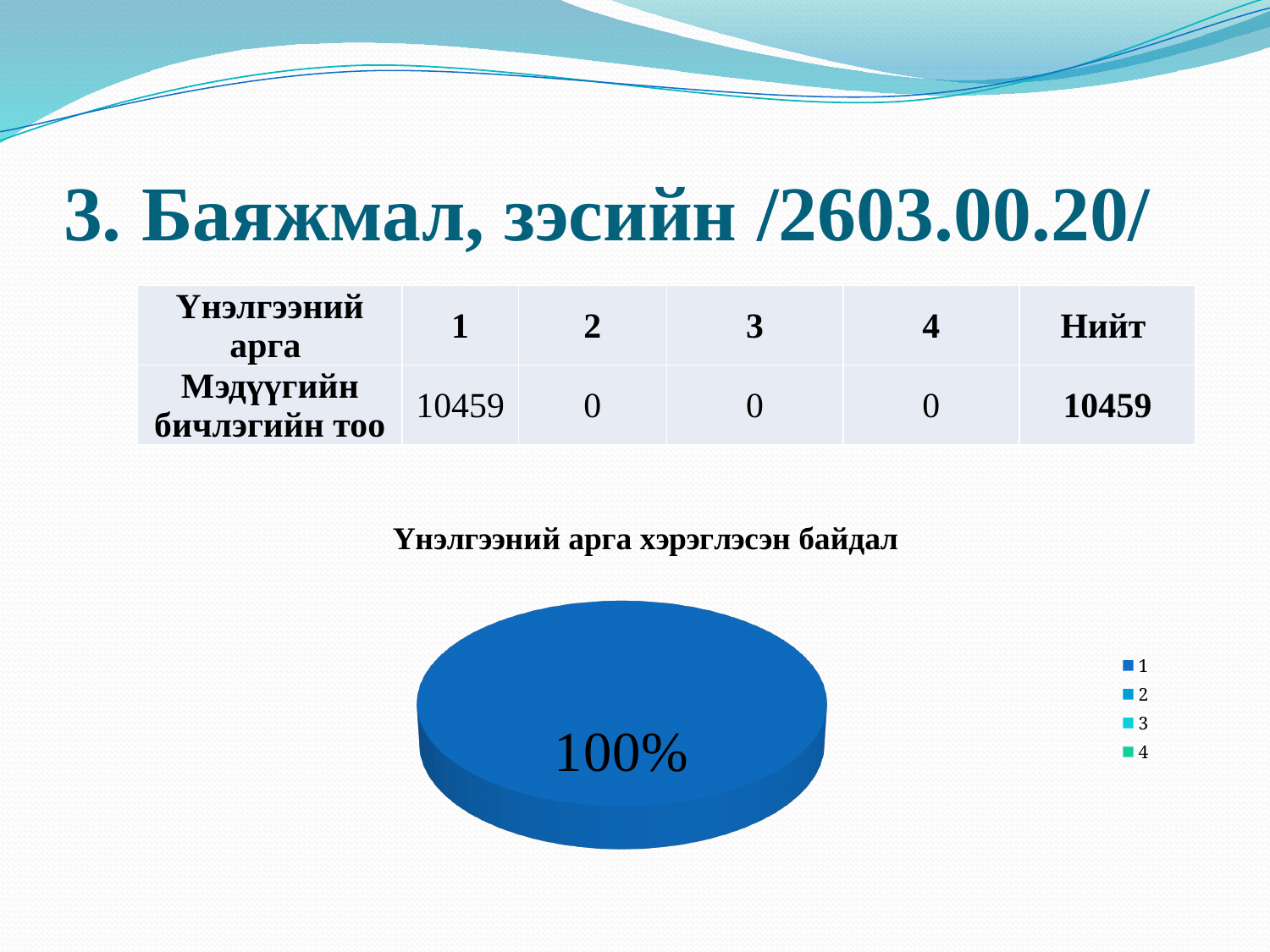
How many slices are visible in the pie? 1 What is the title of the chart? Үнэлгээний арга хэрэглэсэн байдал What share of the pie does the visible slice take up? 100% Which legend category accounts for the entire pie? 1 What kind of chart is shown on the slide? pie chart What colour is the slice that fills the whole pie? blue What percentage label is printed on the pie? 100% How many entries does the chart's legend list? 4 Which is larger in the pie, category 1 or category 2? 1 Is the share of category 1 greater or less than 50%? greater